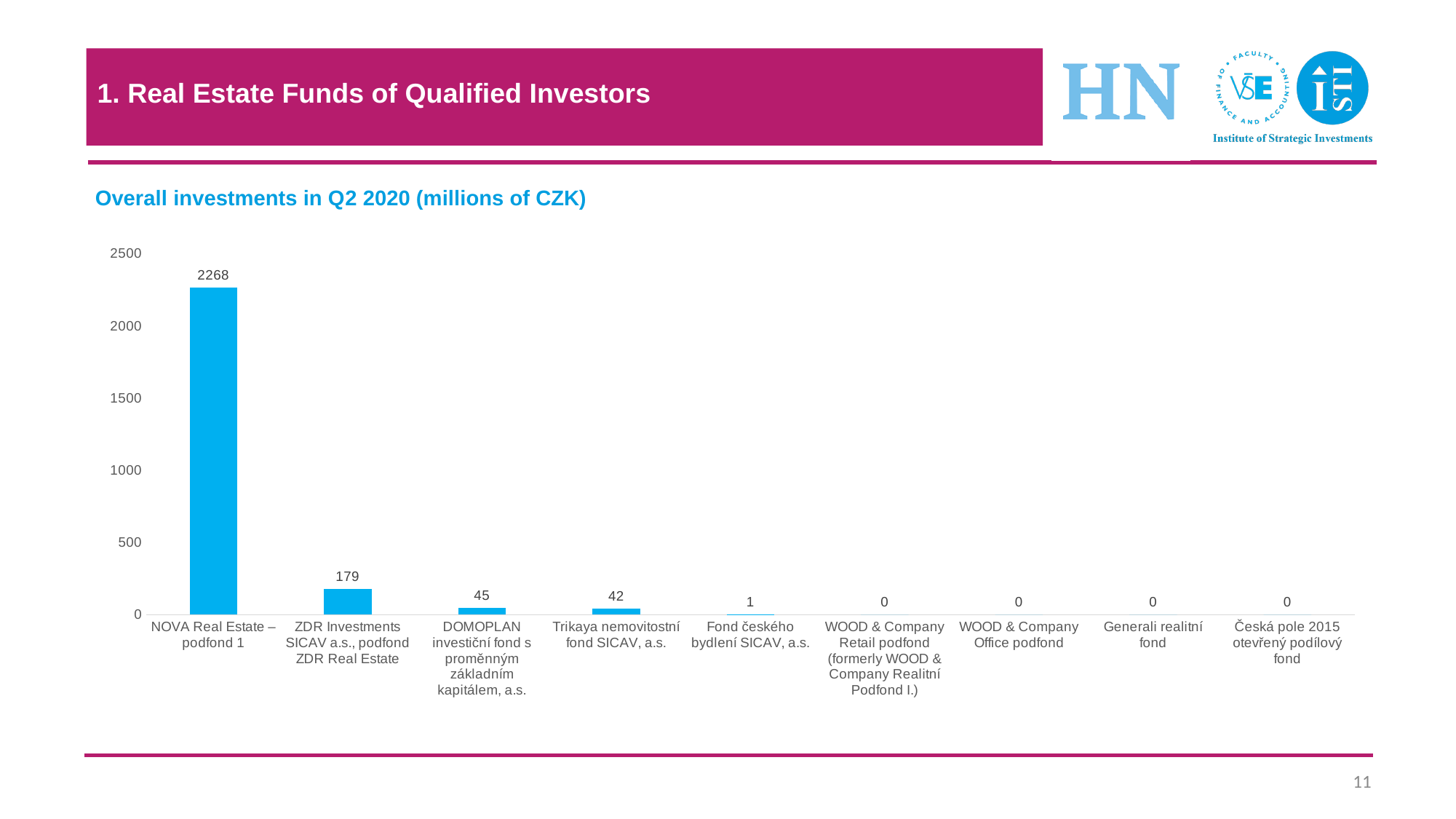
What is the value for Fond českého bydlení SICAV, a.s.? 1 How many funds have a value of 0? 4 What kind of chart is shown on the slide? bar chart Is the value for NOVA Real Estate – podfond 1 greater or less than 2000? greater Which is larger, the value for ZDR Investments SICAV a.s., podfond ZDR Real Estate or the value for DOMOPLAN investiční fond s proměnným základním kapitálem, a.s.? ZDR Investments SICAV a.s., podfond ZDR Real Estate What is the value for Trikaya nemovitostní fond SICAV, a.s.? 42 Which fund has the highest overall investments in Q2 2020? NOVA Real Estate – podfond 1 What is the value for NOVA Real Estate – podfond 1? 2268 What is the difference between the values for DOMOPLAN investiční fond s proměnným základním kapitálem, a.s. and Trikaya nemovitostní fond SICAV, a.s.? 3 What is the value for ZDR Investments SICAV a.s., podfond ZDR Real Estate? 179 How many funds are shown on the chart? 9 What is the difference between the values for NOVA Real Estate – podfond 1 and ZDR Investments SICAV a.s., podfond ZDR Real Estate? 2089